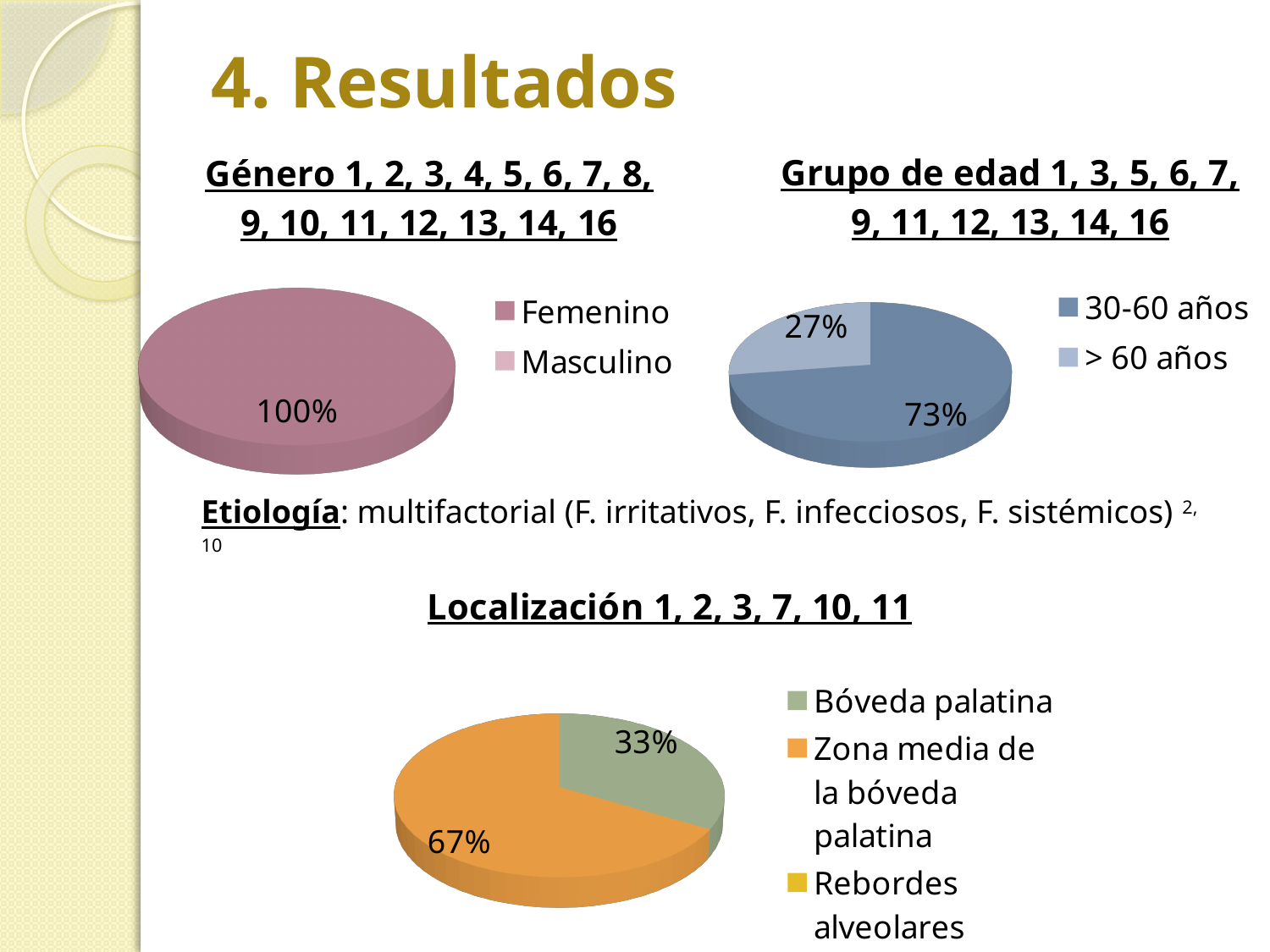
In the Grupo de edad pie chart, what share is labelled for > 60 años? 27% In the Localización pie chart, what share is labelled for Zona media de la bóveda palatina? 67% In the Grupo de edad pie chart, what share is labelled for 30-60 años? 73% What kind of chart is used for the Grupo de edad data? pie chart In the Localización pie chart, is the slice for Zona media de la bóveda palatina larger or smaller than the slice for Bóveda palatina? larger In the Localización pie chart, which category has the smallest labelled slice? Bóveda palatina In the Localización pie chart, what share is labelled for Bóveda palatina? 33% In the Género pie chart, what share is labelled for Femenino? 100% How many entries does the legend of the Género chart list? 2 How many entries does the legend of the Localización chart list? 3 In the Grupo de edad pie chart, what is the difference in percentage points between the 30-60 años slice and the > 60 años slice? 46 In the Grupo de edad pie chart, which age group has the larger slice? 30-60 años